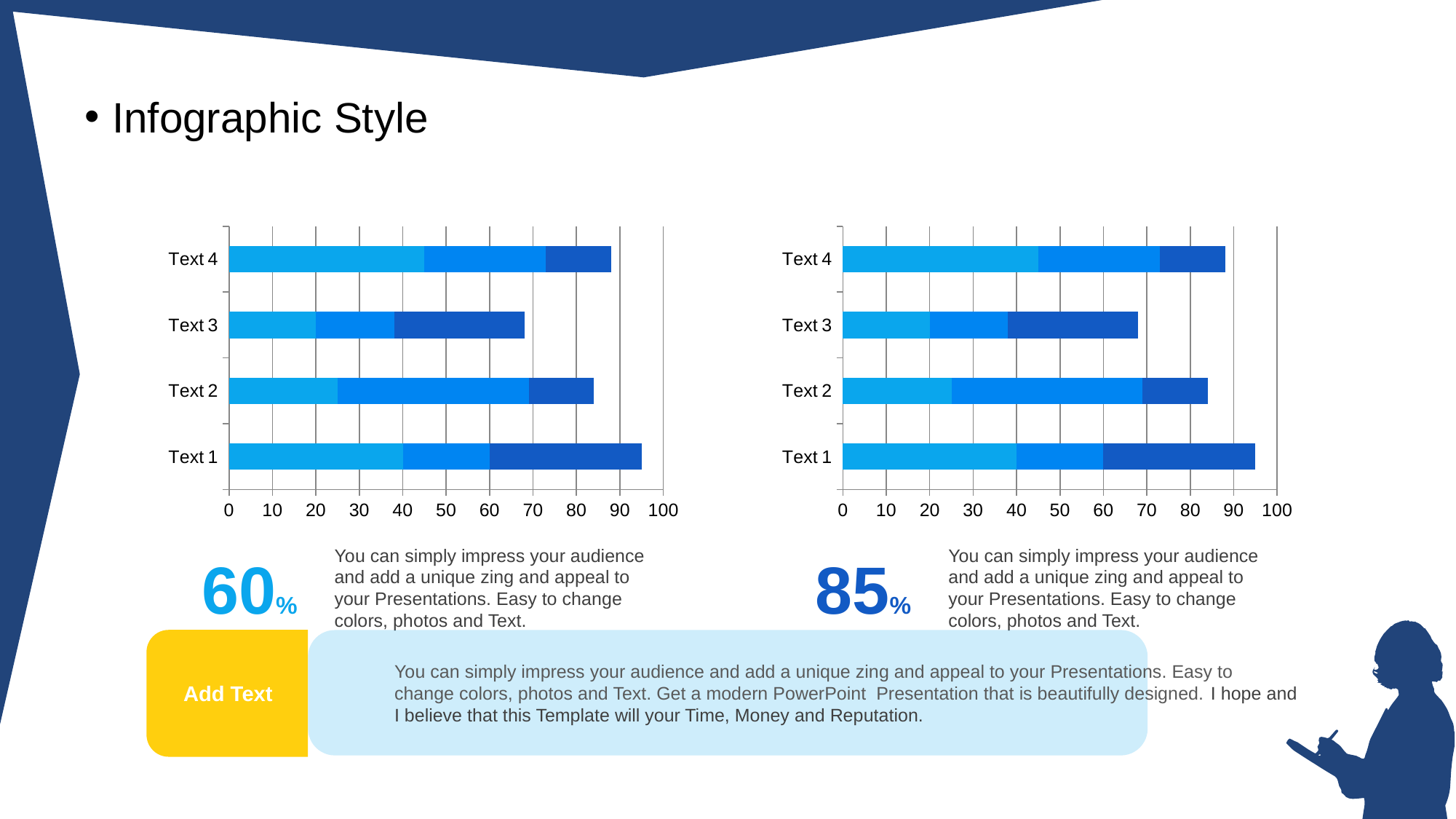
What kind of chart is the left chart on the slide? bar chart In the left chart, which category has the shortest total bar? Text 3 In the left chart, which category has the longest total bar? Text 1 How many categories does the left chart show? 4 In the left chart, is the total bar for Text 3 greater or less than 70? less In the right chart, which total bar is longer, Text 4 or Text 3? Text 4 In the left chart, is the total bar for Text 1 greater or less than 90? greater What is the category label of the bottom bar in the left chart? Text 1 How many categories does the right chart show? 4 In the right chart, which total bar is longer, Text 1 or Text 3? Text 1 In the right chart, is the total bar for Text 2 greater or less than 80? greater What is the highest value shown on the x axis of the right chart? 100